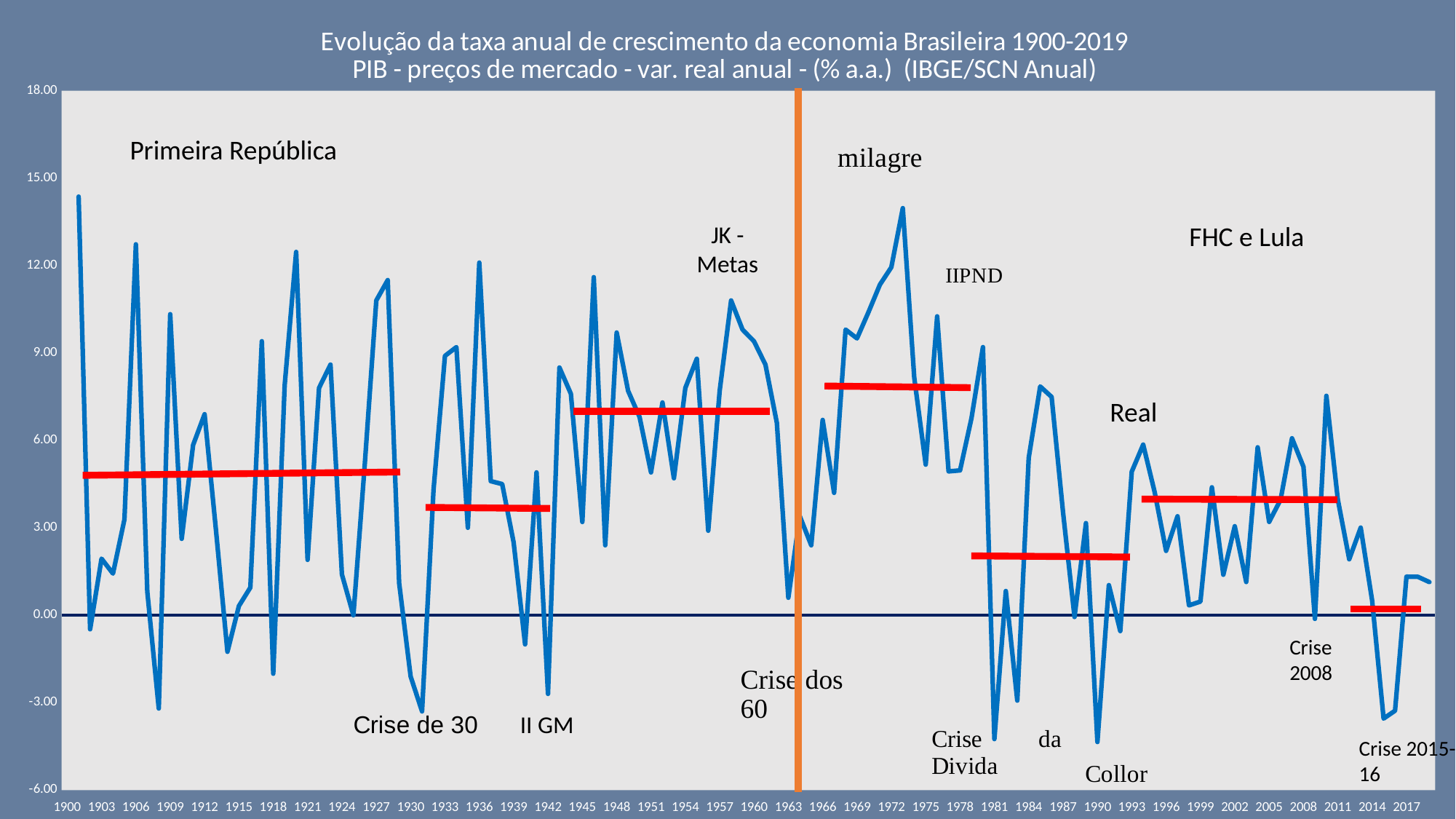
Does the line rise or fall between 1900 and 1902? fall Does the line rise or fall between 1967 and 1973? rise What kind of chart is shown on the slide? line chart What is the highest value shown on the y axis? 18.00 Is the value for 1981 greater or less than 0.00? less What is the title of the chart? Evolução da taxa anual de crescimento da economia Brasileira 1900-2019 PIB - preços de mercado - var. real anual - (% a.a.) (IBGE/SCN Anual) Is the value for 1973 greater or less than 12.00? greater Is the value for 1930 greater or less than 0.00? less How many year labels are shown on the x axis? 40